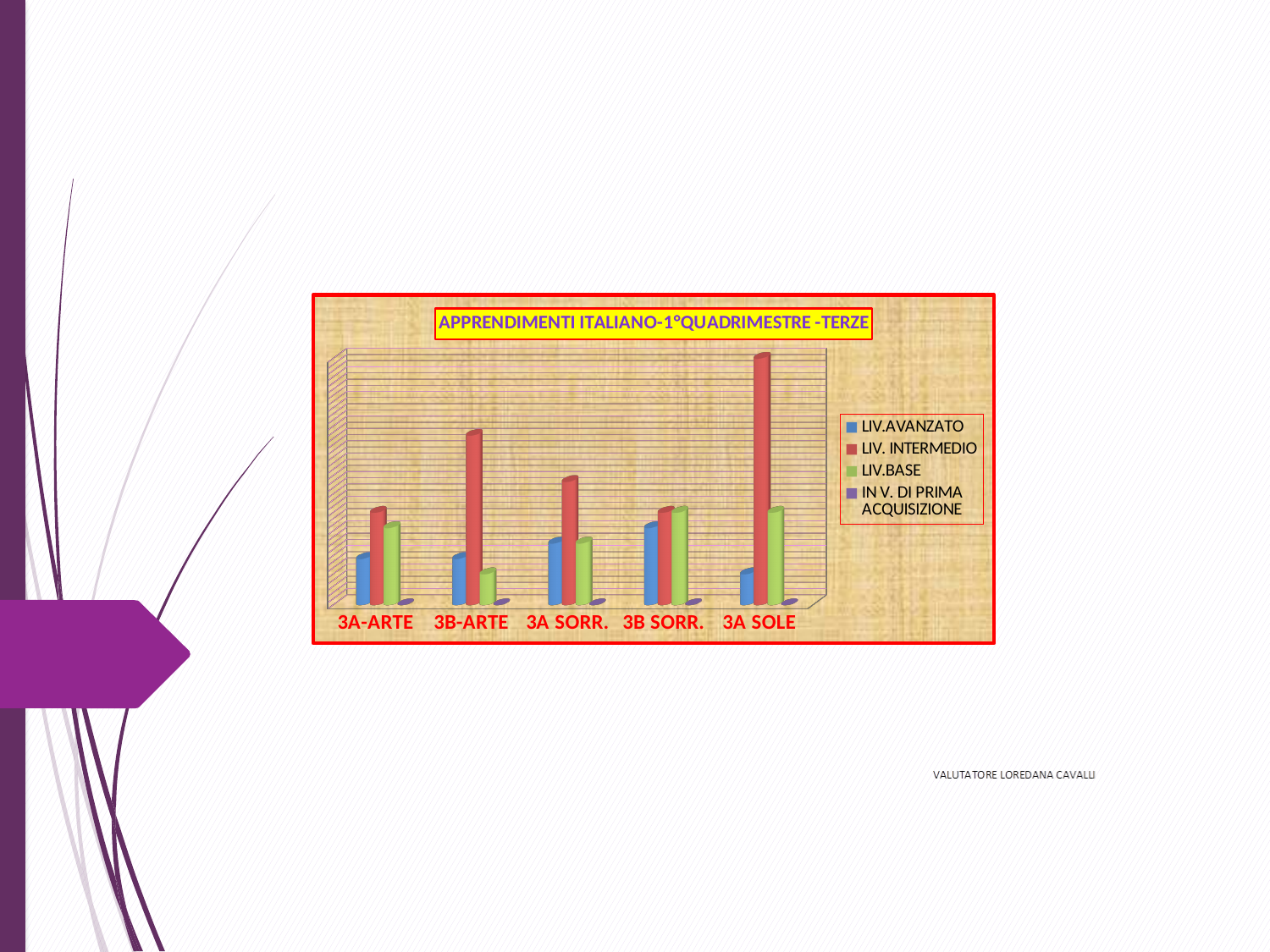
Which class has the lowest LIV.BASE bar? 3B-ARTE Which colour represents LIV. INTERMEDIO in the chart's legend? Red For 3A-ARTE, which is larger: LIV.AVANZATO or LIV.BASE? LIV.BASE Which class has the highest LIV. INTERMEDIO bar? 3A SOLE For 3A SOLE, which is larger: LIV. INTERMEDIO or LIV.BASE? LIV. INTERMEDIO What is the title of the chart? APPRENDIMENTI ITALIANO-1°QUADRIMESTRE -TERZE What kind of chart is shown on the slide? Bar chart How many categories (classes) are shown on the x axis of the chart? 5 Which class has the highest LIV.AVANZATO bar? 3B SORR. How many series does the chart's legend list? 4 For 3B-ARTE, which is larger: LIV. INTERMEDIO or LIV.BASE? LIV. INTERMEDIO